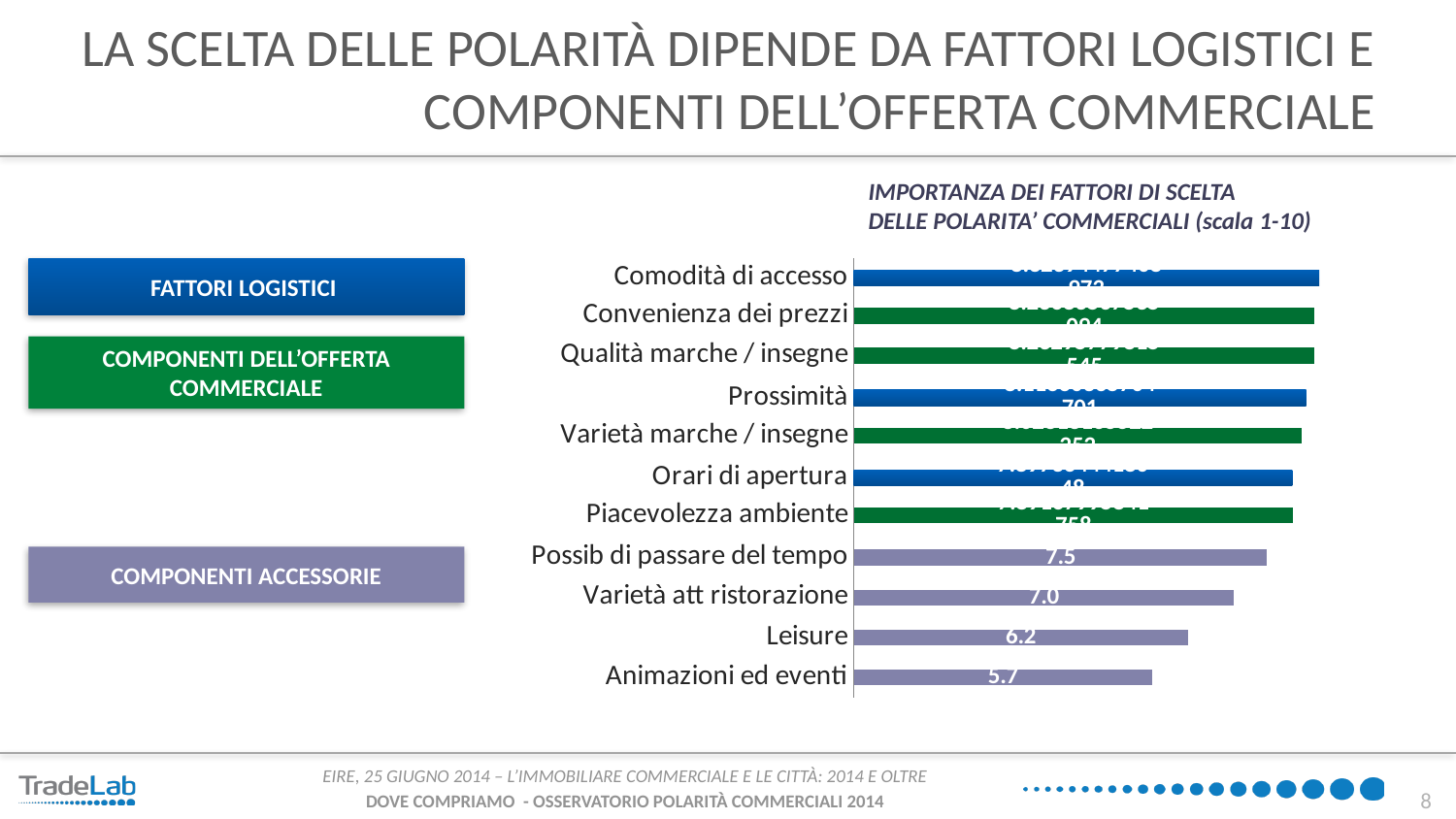
What is the title of the chart? IMPORTANZA DEI FATTORI DI SCELTA DELLE POLARITA' COMMERCIALI (scala 1-10) Which category has the lowest value in the chart? Animazioni ed eventi What kind of chart is shown on the slide? Bar chart Which is larger, the value for Orari di apertura or the value for Leisure? Orari di apertura What is the value for Possib di passare del tempo? 7.5 Which is larger, the value for Leisure or the value for Animazioni ed eventi? Leisure What is the difference between the values for Possib di passare del tempo and Varietà att ristorazione? 0.5 How many categories are shown in the chart? 11 What is the value for Varietà att ristorazione? 7.0 What is the difference between the values for Leisure and Animazioni ed eventi? 0.5 What is the value for Leisure? 6.2 What is the value for Animazioni ed eventi? 5.7